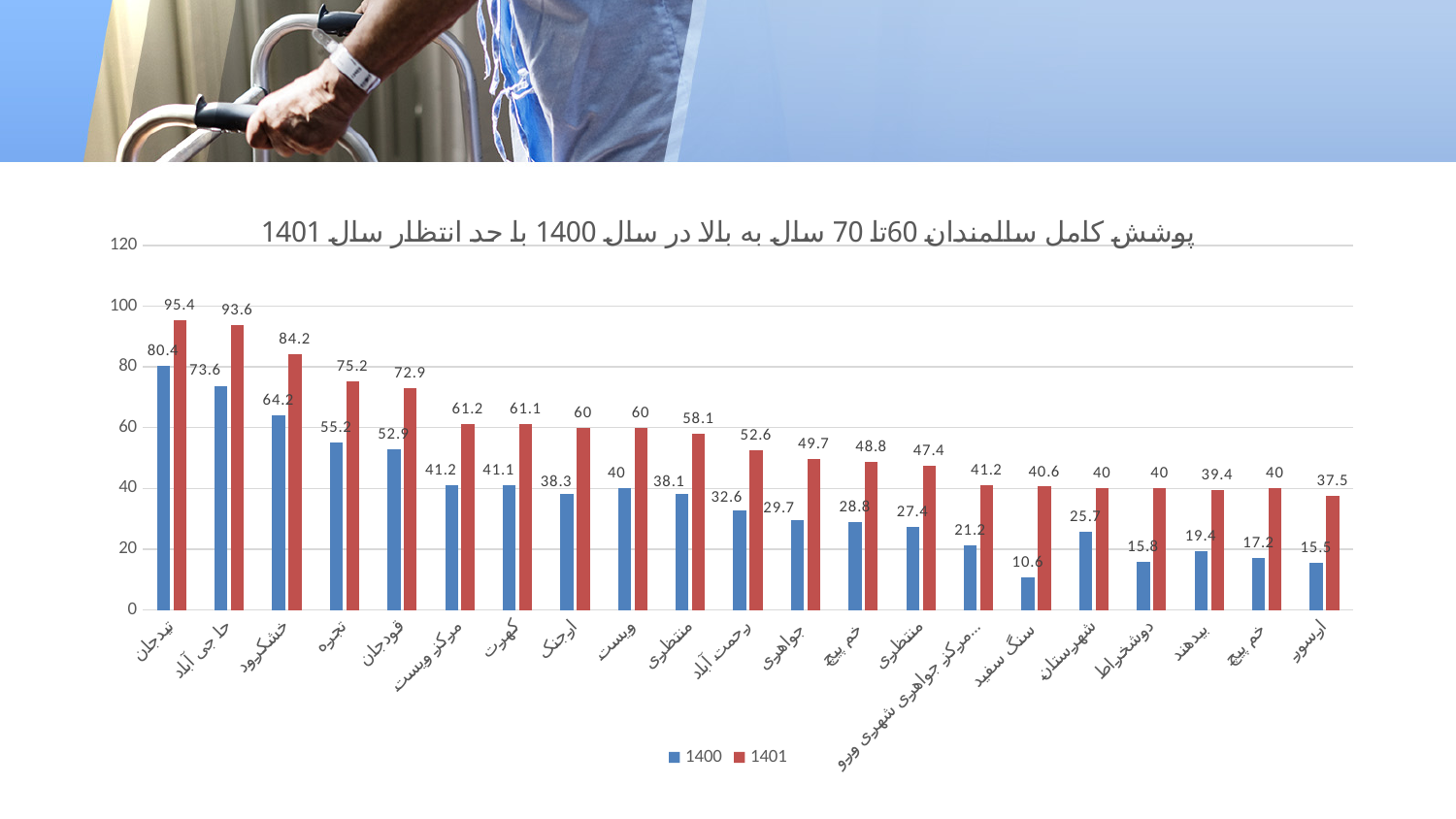
Which category has the lowest 1400 value? سنگ سفید How many categories are shown on the x axis? 21 What is the difference between the 1401 and 1400 values for تیدجان? 15 What is the 1400 value for حاجی آباد? 73.6 What is the difference between the 1401 and 1400 values for سنگ سفید? 30 What is the 1401 value for خشکرود? 84.2 What are the two series named in the legend? 1400 and 1401 Which category has the highest 1401 value? تیدجان For سنگ سفید, which series has the larger value, 1400 or 1401? 1401 What type of chart is shown on the slide? Bar chart How many series does the legend list? 2 What is the 1401 value for ارسور? 37.5